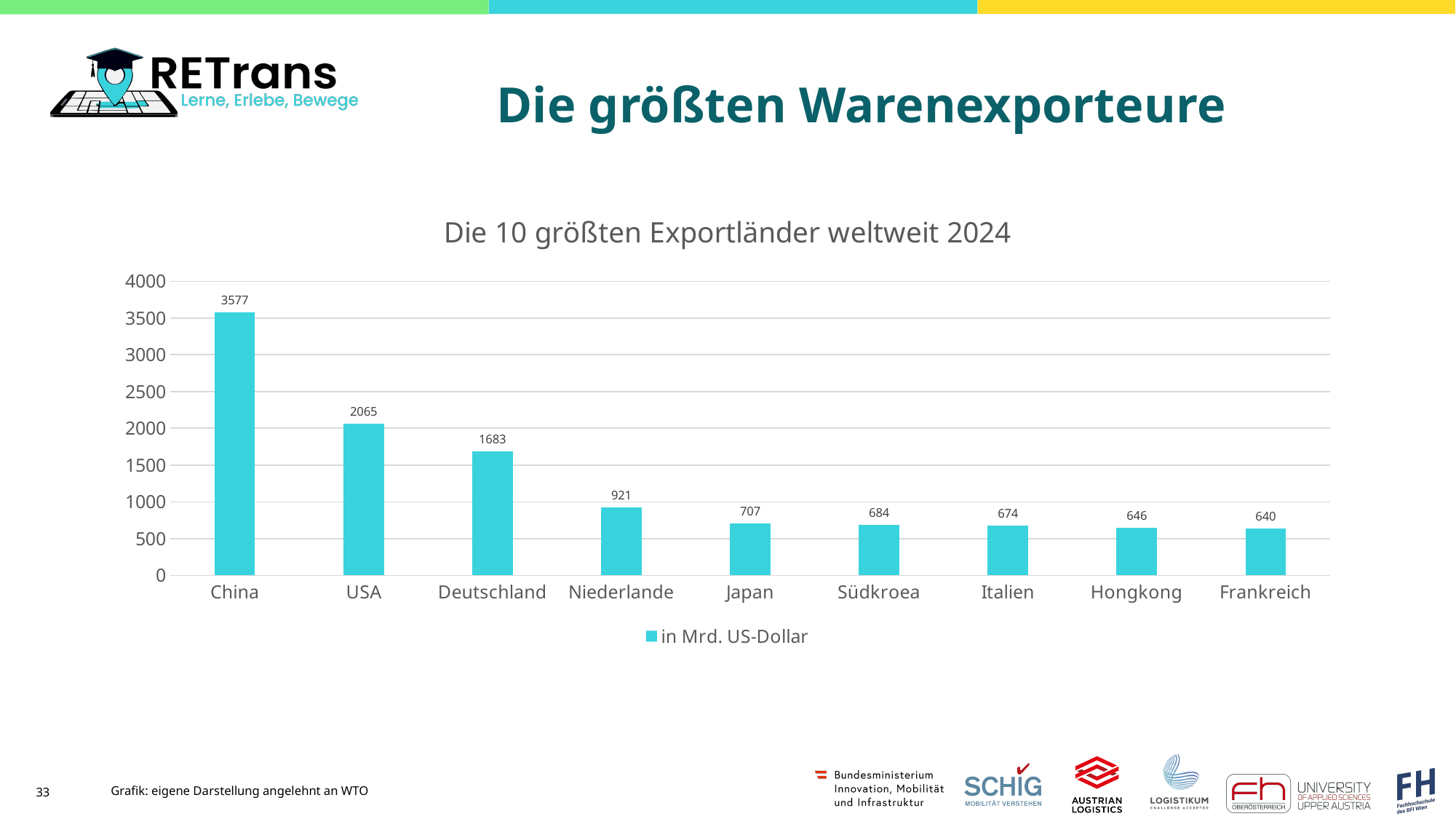
What is the value for Hongkong? 646 Which is larger, the value for USA or the value for Deutschland? USA Which country has the highest value? China What is the value for Deutschland? 1683 What is the difference between the values for China and USA? 1512 What is the difference between the values for Niederlande and Japan? 214 What is the value for China? 3577 What is the title of the chart? Die 10 größten Exportländer weltweit 2024 How many series does the legend list? 1 What kind of chart is shown? bar chart Which country has the lowest value? Frankreich How many countries are shown in the chart? 9